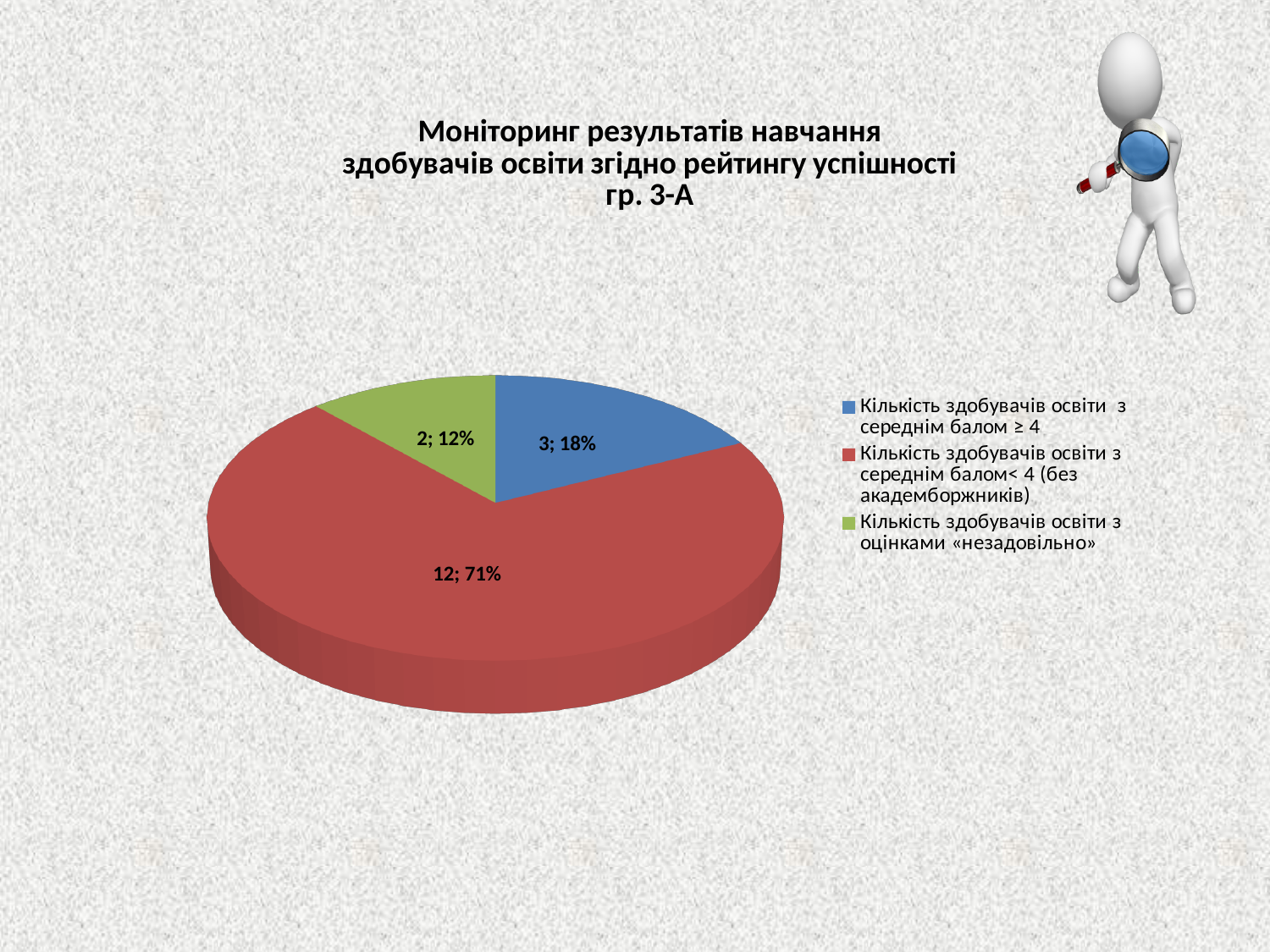
What is the difference between the value for "Кількість здобувачів освіти з середнім балом< 4 (без академборжників)" and the value for "Кількість здобувачів освіти з середнім балом ≥ 4"? 9 How many entries does the legend list? 3 What kind of chart is shown on the slide? pie chart What share of the pie does "Кількість здобувачів освіти з середнім балом< 4 (без академборжників)" take? 71% Which category has the largest slice? Кількість здобувачів освіти з середнім балом< 4 (без академборжників) How many slices does the pie chart have? 3 What colour is the slice for "Кількість здобувачів освіти з середнім балом ≥ 4"? blue What is the value for "Кількість здобувачів освіти з середнім балом< 4 (без академборжників)"? 12 What share of the pie does "Кількість здобувачів освіти з оцінками «незадовільно»" take? 12% Which category has the smallest slice? Кількість здобувачів освіти з оцінками «незадовільно» What is the value for "Кількість здобувачів освіти з оцінками «незадовільно»"? 2 What is the value for "Кількість здобувачів освіти з середнім балом ≥ 4"? 3